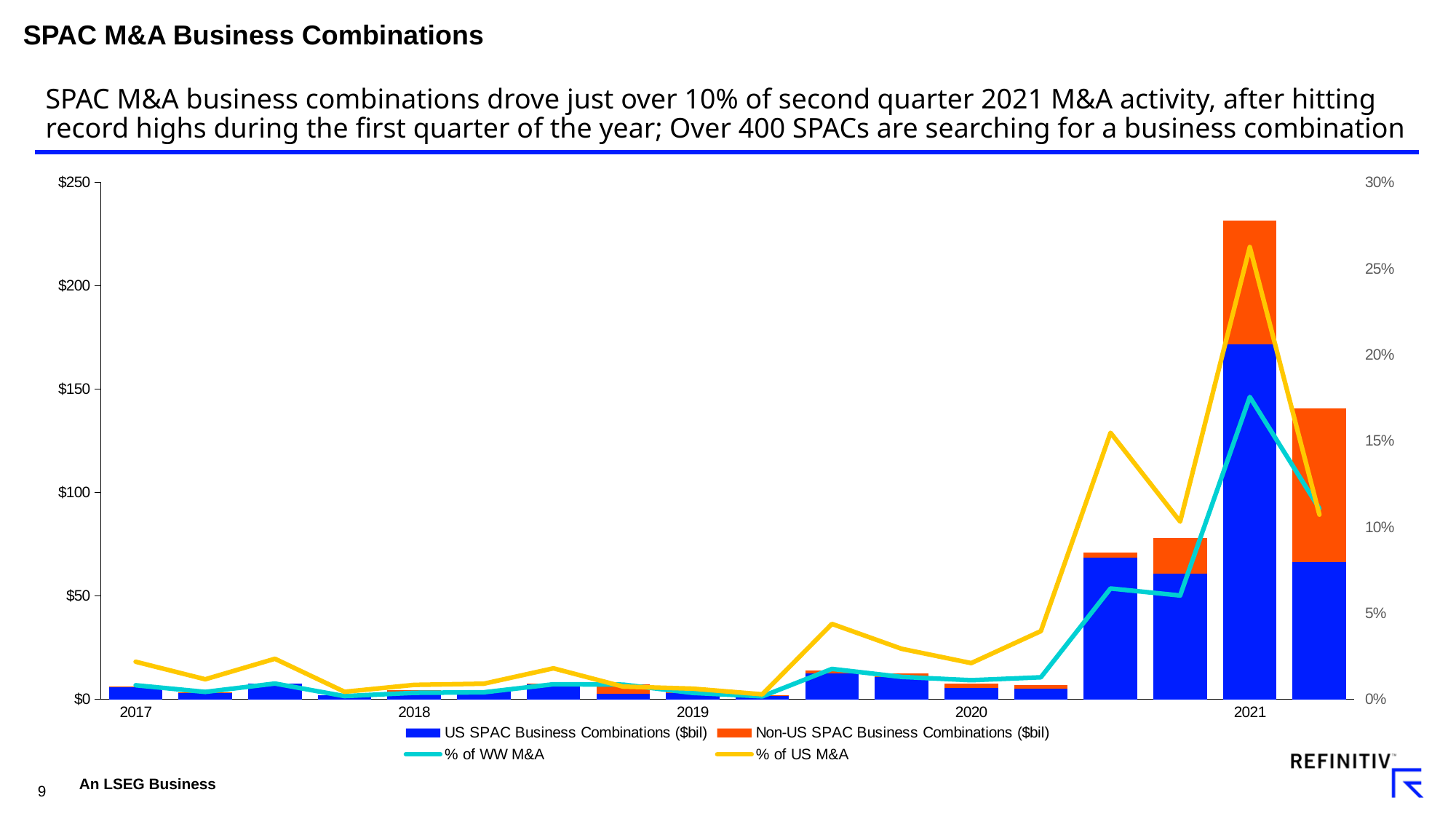
Do the stacked bar totals generally rise or fall from 2017 to the first quarter of 2021? rise How many bars are plotted in the chart? 18 Is the peak of the % of US M&A line greater or less than 20%? greater How many series does the legend list? 4 What is the highest value shown on the right-hand percentage axis? 30% At the 2021 peak, which line is higher: % of WW M&A or % of US M&A? % of US M&A What kind of chart is shown on the slide? A combination chart of stacked bars and lines Is the peak of the % of WW M&A line greater or less than 20%? less Which colour represents US SPAC Business Combinations ($bil) in the legend? Blue Which year contains the tallest stacked bar? 2021 Is the total of the last stacked bar (second bar of 2021) greater or less than $100? greater